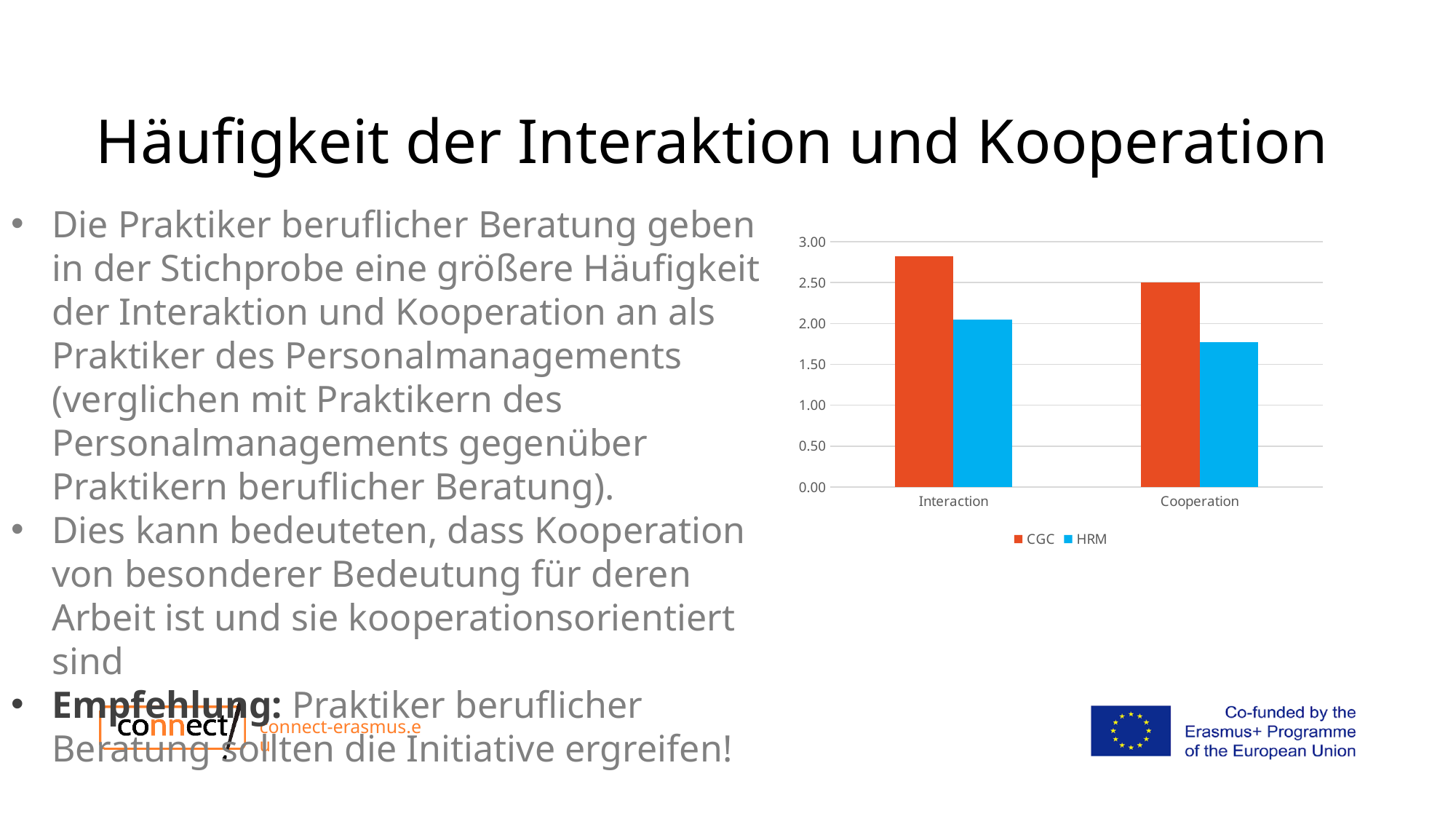
How many categories are shown on the x axis of the chart? 2 Which series is shown in orange-red in the chart? CGC Which series and category has the lowest bar in the chart? HRM, Cooperation How many series does the chart legend list? 2 Is the HRM value for Cooperation greater or less than 1.50? greater Is the HRM value for Cooperation greater or less than 2.00? less Is the CGC value for Interaction greater or less than 2.50? greater What is the highest value shown on the chart's vertical axis? 3.00 Which series and category has the highest bar in the chart? CGC, Interaction For Interaction, which series has the larger value, CGC or HRM? CGC For Cooperation, which series has the larger value, CGC or HRM? CGC What kind of chart is shown on the slide? bar chart